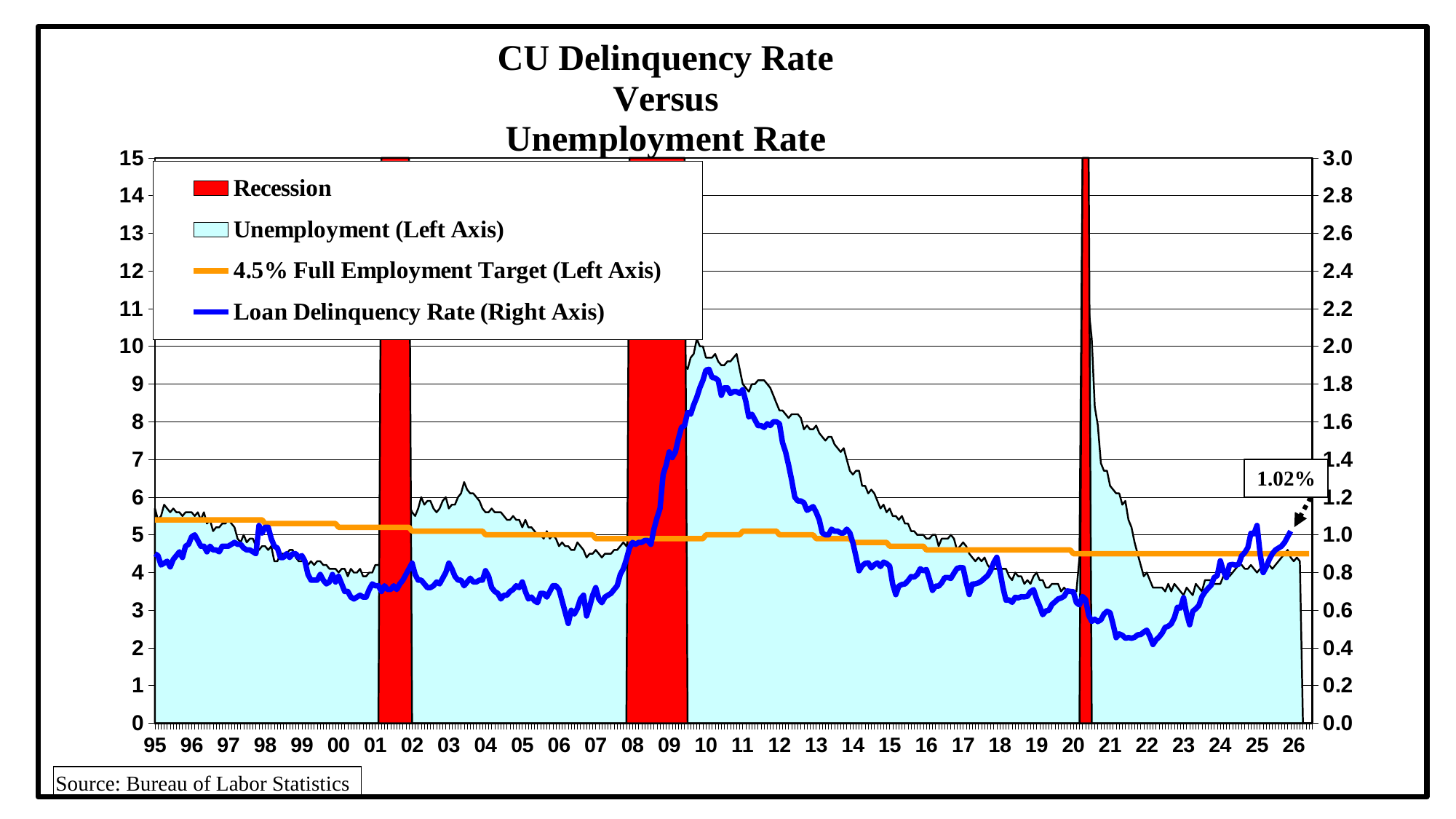
Does the Loan Delinquency Rate rise or fall from 2022 to 2026? rise What kind of chart is shown on the slide? combination area and line chart In which year does the Unemployment series reach its highest peak? 2020 Which is higher: the Unemployment peak in 2020 or the Unemployment peak in 2010? 2020 How many entries does the chart's legend list? 4 Is the peak Unemployment value in 2020 greater or less than 10? greater What is the labelled value of the Loan Delinquency Rate at the end of the series (around 2026)? 1.02% What is the title of the chart? CU Delinquency Rate Versus Unemployment Rate What is the value of the Full Employment Target line according to the legend? 4.5% Around which year is the Loan Delinquency Rate at its lowest? 2022 Is the Loan Delinquency Rate in 2022 greater or less than 0.6? less Is the peak Loan Delinquency Rate around 2010 greater or less than 1.6? greater